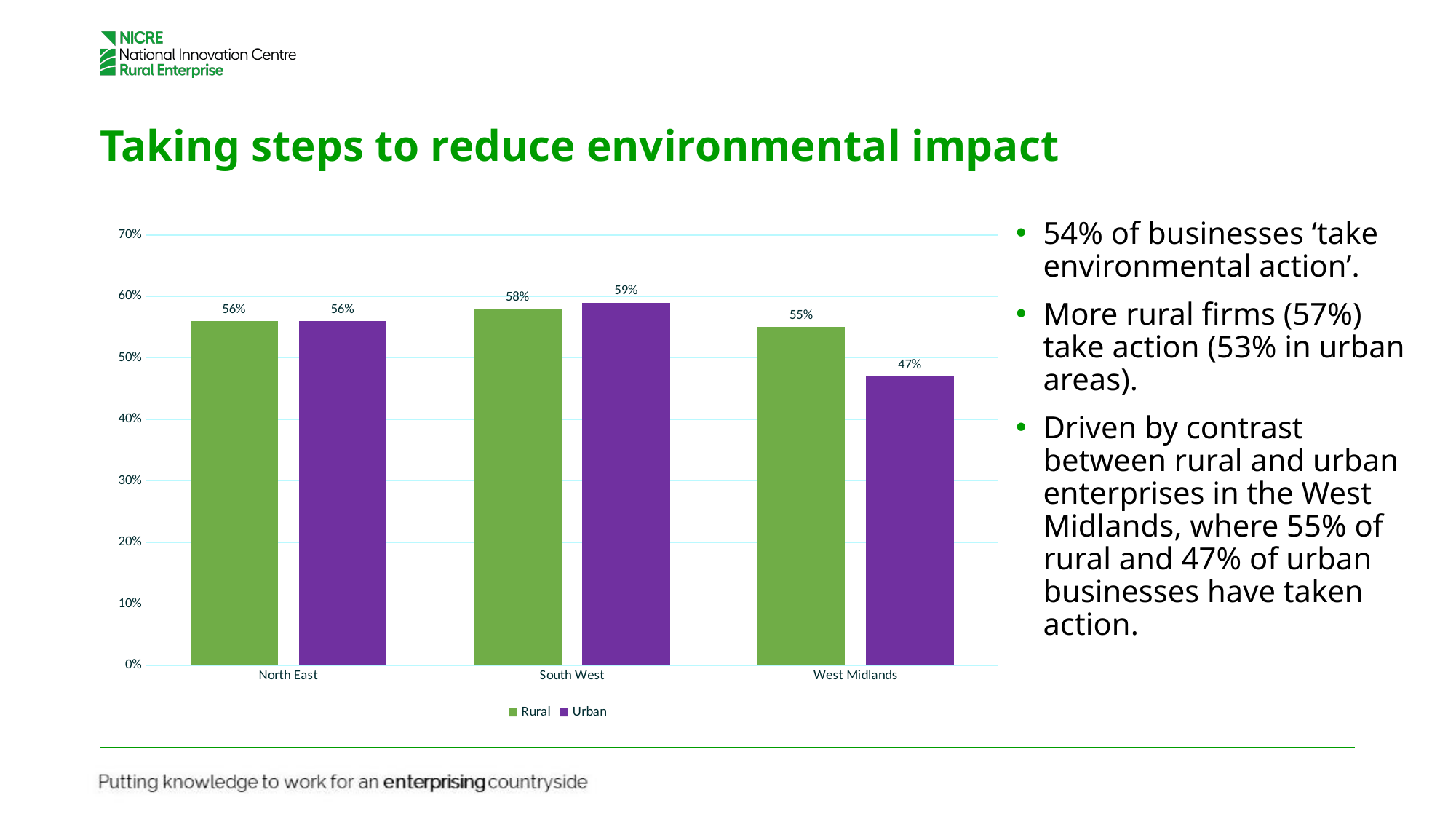
What is the Rural value for South West? 58% Is the Urban value for West Midlands greater or less than 50%? less Which region has the highest Rural value? South West What is the Urban value for West Midlands? 47% What kind of chart is shown on the slide? Bar chart Which colour represents the Urban series in the chart? Purple How many series does the legend list? 2 Which is larger for West Midlands, the Rural value or the Urban value? Rural What is the Urban value for North East? 56% How many regions are shown on the x axis? 3 What is the difference between the Rural and Urban values for West Midlands? 8% Which region has the lowest Urban value? West Midlands